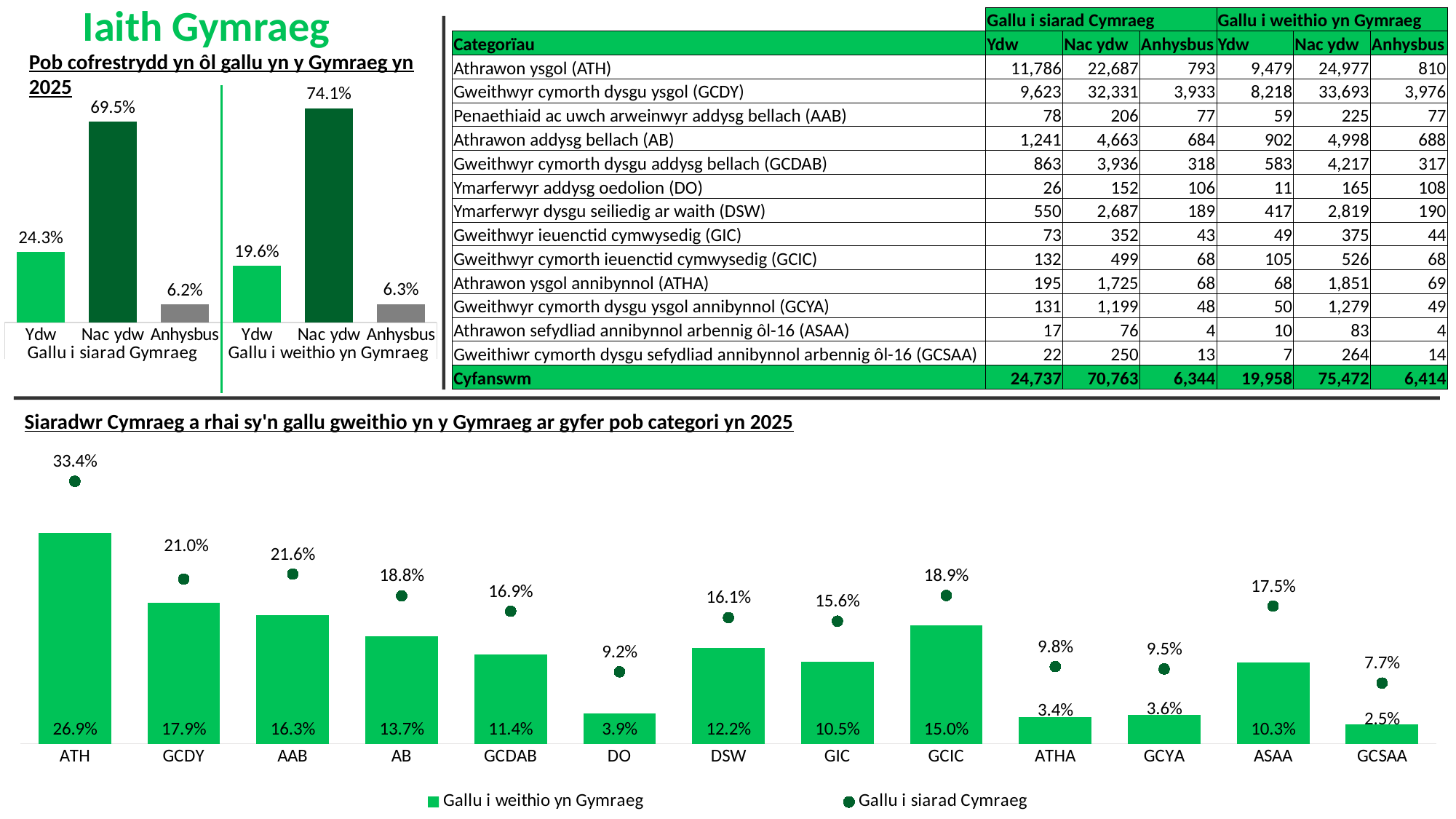
In the bottom chart 'Siaradwr Cymraeg a rhai sy'n gallu gweithio yn y Gymraeg ar gyfer pob categori yn 2025', what is the 'Gallu i weithio yn Gymraeg' value for GCIC? 15.0% In the top-left chart 'Pob cofrestrydd yn ôl gallu yn y Gymraeg yn 2025', which bar is the highest? Nac ydw (Gallu i weithio yn Gymraeg) In the bottom chart 'Siaradwr Cymraeg a rhai sy'n gallu gweithio yn y Gymraeg ar gyfer pob categori yn 2025', what is the difference between the 'Gallu i siarad Cymraeg' and 'Gallu i weithio yn Gymraeg' values for DO? 5.3% In the bottom chart 'Siaradwr Cymraeg a rhai sy'n gallu gweithio yn y Gymraeg ar gyfer pob categori yn 2025', which category has the highest 'Gallu i siarad Cymraeg' value? ATH In the bottom chart 'Siaradwr Cymraeg a rhai sy'n gallu gweithio yn y Gymraeg ar gyfer pob categori yn 2025', which category has the lowest 'Gallu i weithio yn Gymraeg' value? GCSAA How many categories are shown on the x axis of the bottom chart 'Siaradwr Cymraeg a rhai sy'n gallu gweithio yn y Gymraeg ar gyfer pob categori yn 2025'? 13 In the bottom chart 'Siaradwr Cymraeg a rhai sy'n gallu gweithio yn y Gymraeg ar gyfer pob categori yn 2025', which is larger: the 'Gallu i weithio yn Gymraeg' value for DSW or for GIC? DSW In the bottom chart 'Siaradwr Cymraeg a rhai sy'n gallu gweithio yn y Gymraeg ar gyfer pob categori yn 2025', what is the 'Gallu i siarad Cymraeg' value for ATH? 33.4% In the top-left chart 'Pob cofrestrydd yn ôl gallu yn y Gymraeg yn 2025', what is the difference between the 'Ydw' values for 'Gallu i siarad Cymraeg' and 'Gallu i weithio yn Gymraeg'? 4.7% What kind of chart is the top-left chart 'Pob cofrestrydd yn ôl gallu yn y Gymraeg yn 2025'? Bar chart In the top-left chart 'Pob cofrestrydd yn ôl gallu yn y Gymraeg yn 2025', what is the value for 'Nac ydw' under 'Gallu i siarad Cymraeg'? 69.5% In the top-left chart 'Pob cofrestrydd yn ôl gallu yn y Gymraeg yn 2025', what is the value for 'Ydw' under 'Gallu i weithio yn Gymraeg'? 19.6%